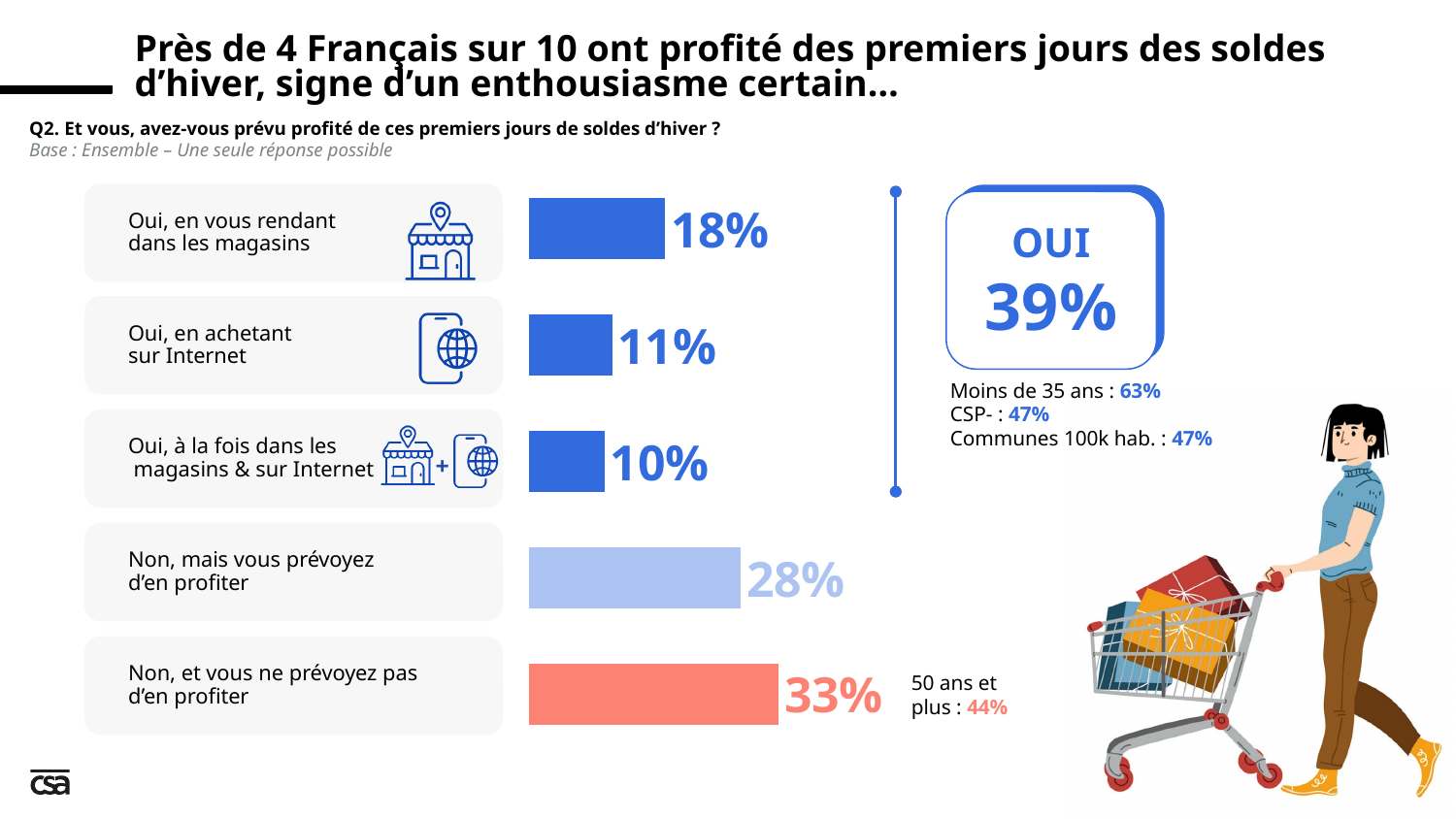
What is the difference between the value for "Non, et vous ne prévoyez pas d'en profiter" and the value for "Non, mais vous prévoyez d'en profiter"? 5% What kind of chart is shown on the slide? Bar chart What is the total share of respondents who answered "Oui" according to the summary box? 39% What is the value for "Oui, à la fois dans les magasins & sur Internet"? 10% What percentage answered "Non, mais vous prévoyez d'en profiter"? 28% Which category has the highest value in the bar chart? Non, et vous ne prévoyez pas d'en profiter Which category has the lowest value in the bar chart? Oui, à la fois dans les magasins & sur Internet Which is larger: the value for "Oui, en vous rendant dans les magasins" or the value for "Oui, en achetant sur Internet"? Oui, en vous rendant dans les magasins How many categories are shown in the bar chart? 5 What is the value for "Oui, en achetant sur Internet"? 11% What percentage of respondents said they took advantage of the sales by going to stores ("Oui, en vous rendant dans les magasins")? 18% What colour is the bar for "Non, et vous ne prévoyez pas d'en profiter"? Red (salmon)